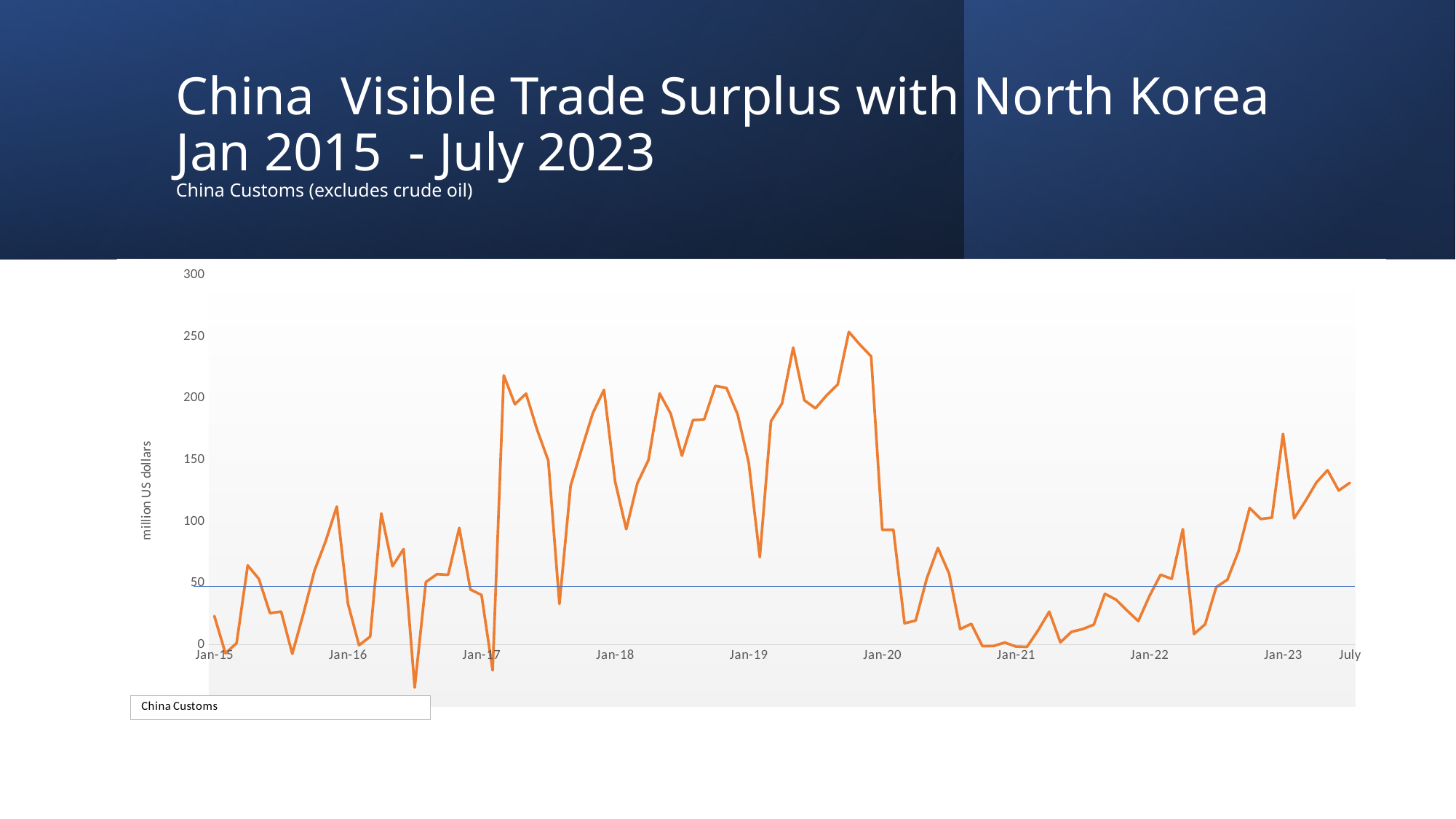
Which is larger, the value at Jan-20 or the value at Jan-21? Jan-20 Is the value at Jan-21 greater or less than 50? less Is the value at Jan-20 greater or less than 200? less What unit is shown on the vertical axis label? million US dollars Among the labelled x-axis points Jan-15 through Jan-23, which has the highest value? Jan-23 What is the title of the chart on the slide? China Visible Trade Surplus with North Korea Jan 2015 - July 2023 What kind of chart is shown on the slide? line chart Between Jan-21 and July 2023, do the values generally rise or fall? rise Is the value at Jan-15 greater or less than 50? less How many lines (series) are plotted on the chart? 1